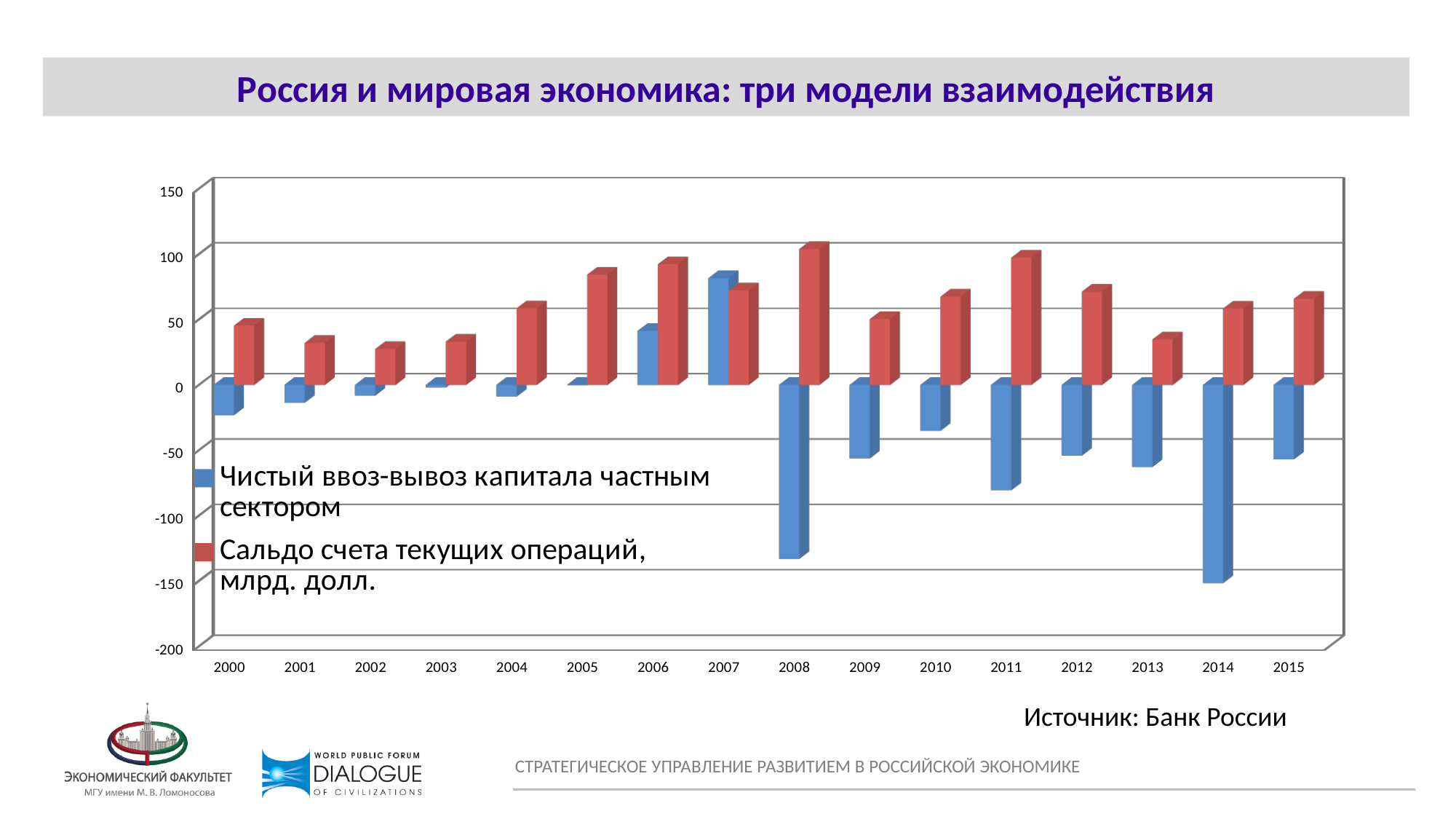
How many series does the chart's legend list? 2 What colour represents 'Сальдо счета текущих операций, млрд. долл.' in the chart? Red Is the value for 'Чистый ввоз-вывоз капитала частным сектором' in 2008 greater or less than -100? less Does the value for 'Сальдо счета текущих операций' rise or fall from 2002 to 2006? rise What kind of chart is shown on the slide? Bar chart Which is larger, the value for 'Сальдо счета текущих операций' in 2005 or in 2002? 2005 How many years are shown on the x axis of the chart? 16 In which year is the value for 'Чистый ввоз-вывоз капитала частным сектором' the lowest? 2014 Is the value for 'Сальдо счета текущих операций' in 2011 greater or less than 50? greater Which is larger, the value for 'Чистый ввоз-вывоз капитала частным сектором' in 2008 or in 2014? 2008 Is the value for 'Сальдо счета текущих операций' in 2013 greater or less than 50? less In which year is the value for 'Чистый ввоз-вывоз капитала частным сектором' the highest? 2007